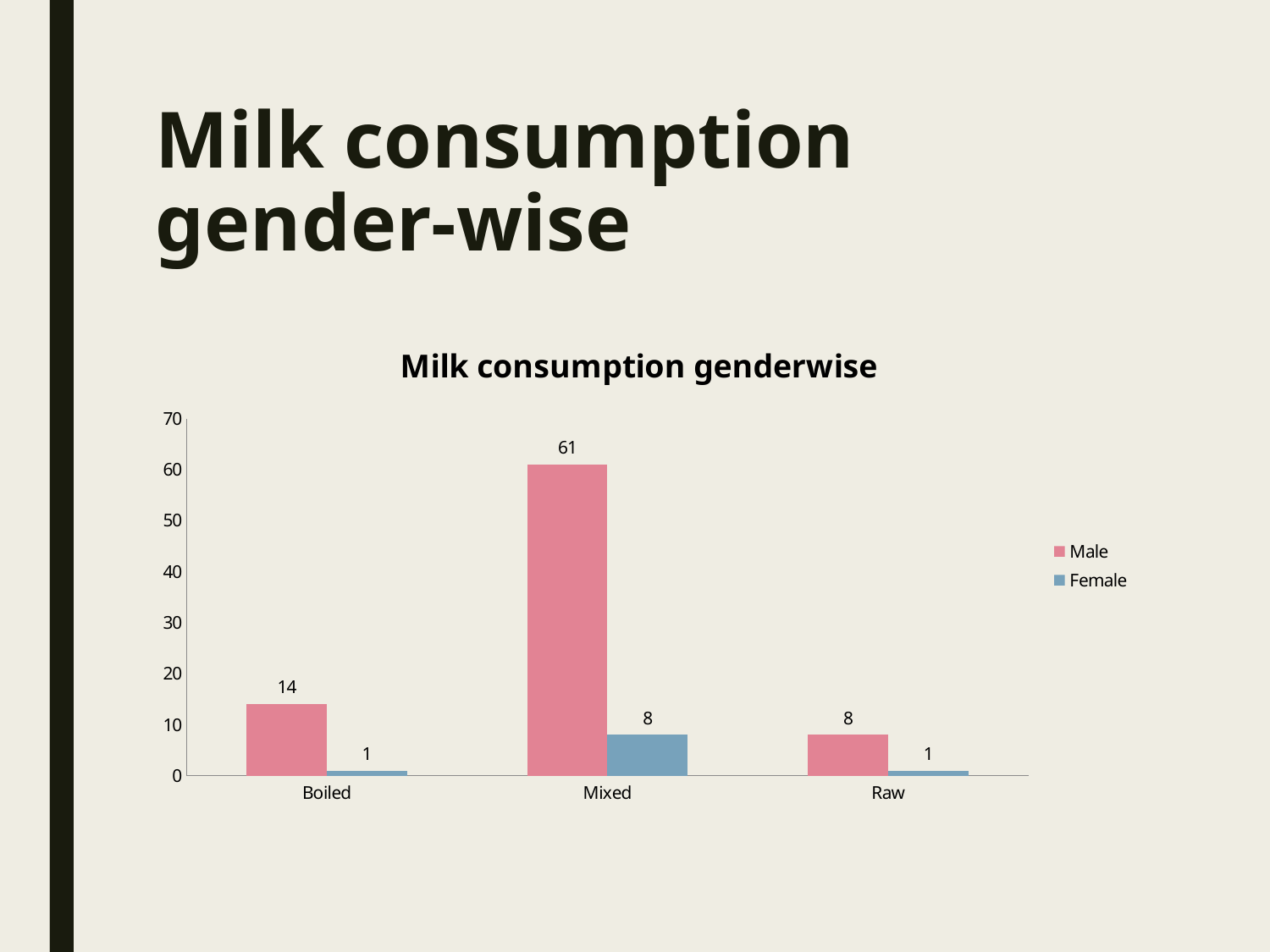
Which is larger, the Male value for Boiled or the Male value for Raw? Boiled What is the Female value for Boiled? 1 How many series does the legend list? 2 Which category has the lowest Male value? Raw How many categories are shown on the x axis? 3 What is the difference between the Male values for Boiled and Raw? 6 What is the Male value for Mixed? 61 What is the Female value for Mixed? 8 Which category has the highest Male value? Mixed What kind of chart is shown? Bar chart What is the difference between the Male and Female values for Mixed? 53 What is the Male value for Raw? 8